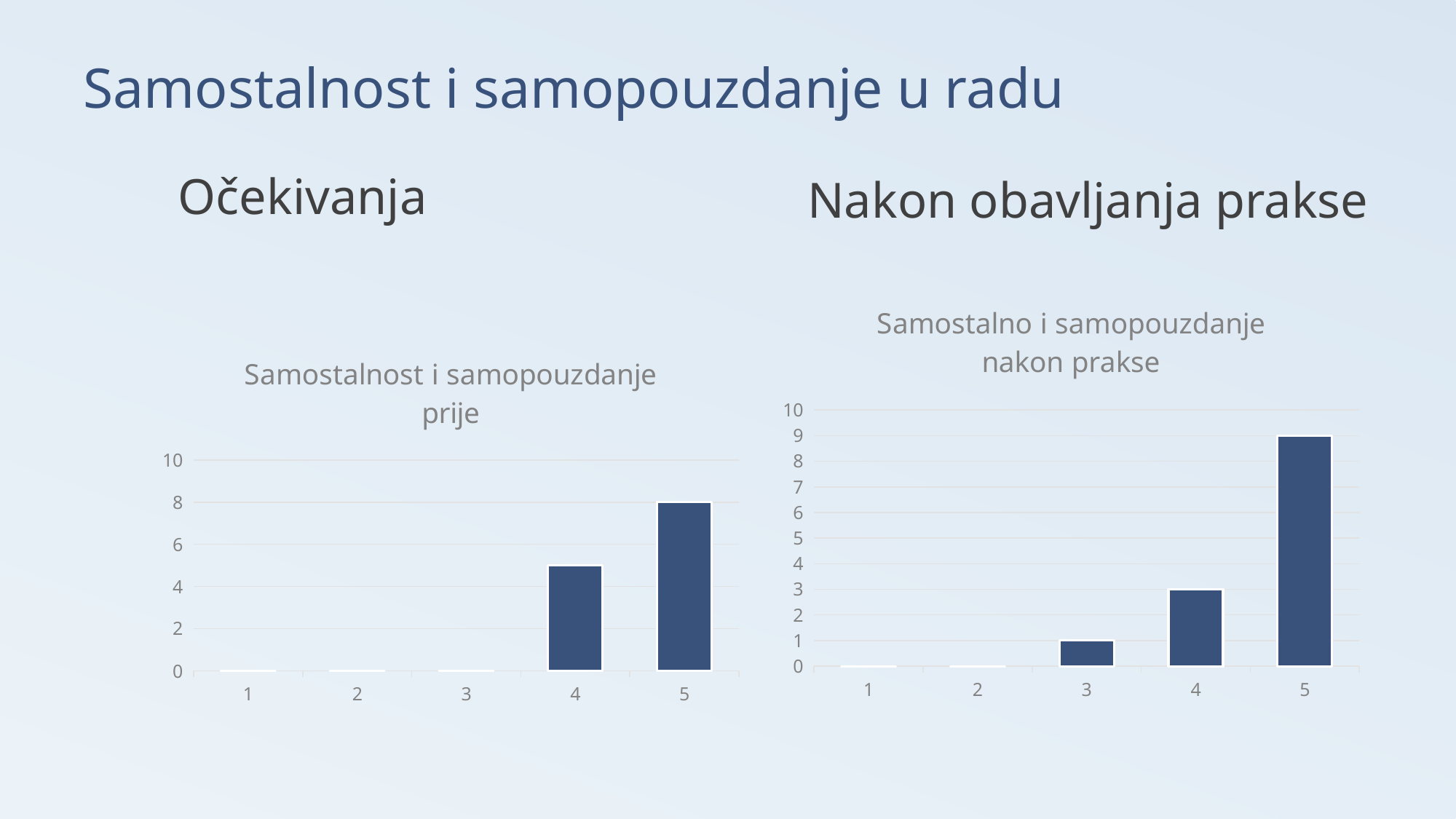
In the left chart "Samostalnost i samopouzdanje prije", which category has the highest value? 5 What is the title of the right chart on the slide? Samostalno i samopouzdanje nakon prakse What kind of chart is the left chart titled "Samostalnost i samopouzdanje prije"? bar chart In the left chart "Samostalnost i samopouzdanje prije", is the value for category 4 greater or less than 4? greater In the right chart "Samostalno i samopouzdanje nakon prakse", which is larger, the value for category 3 or category 4? category 4 In the right chart "Samostalno i samopouzdanje nakon prakse", what is the value for category 3? 1 In the right chart "Samostalno i samopouzdanje nakon prakse", what is the value for category 4? 3 In the left chart "Samostalnost i samopouzdanje prije", what is the value for category 5? 8 In the left chart "Samostalnost i samopouzdanje prije", how many categories are shown on the x axis? 5 In the right chart "Samostalno i samopouzdanje nakon prakse", do the values rise or fall from category 3 to category 5? rise In the right chart "Samostalno i samopouzdanje nakon prakse", what is the difference between the values for category 5 and category 4? 6 In the right chart "Samostalno i samopouzdanje nakon prakse", what is the value for category 5? 9